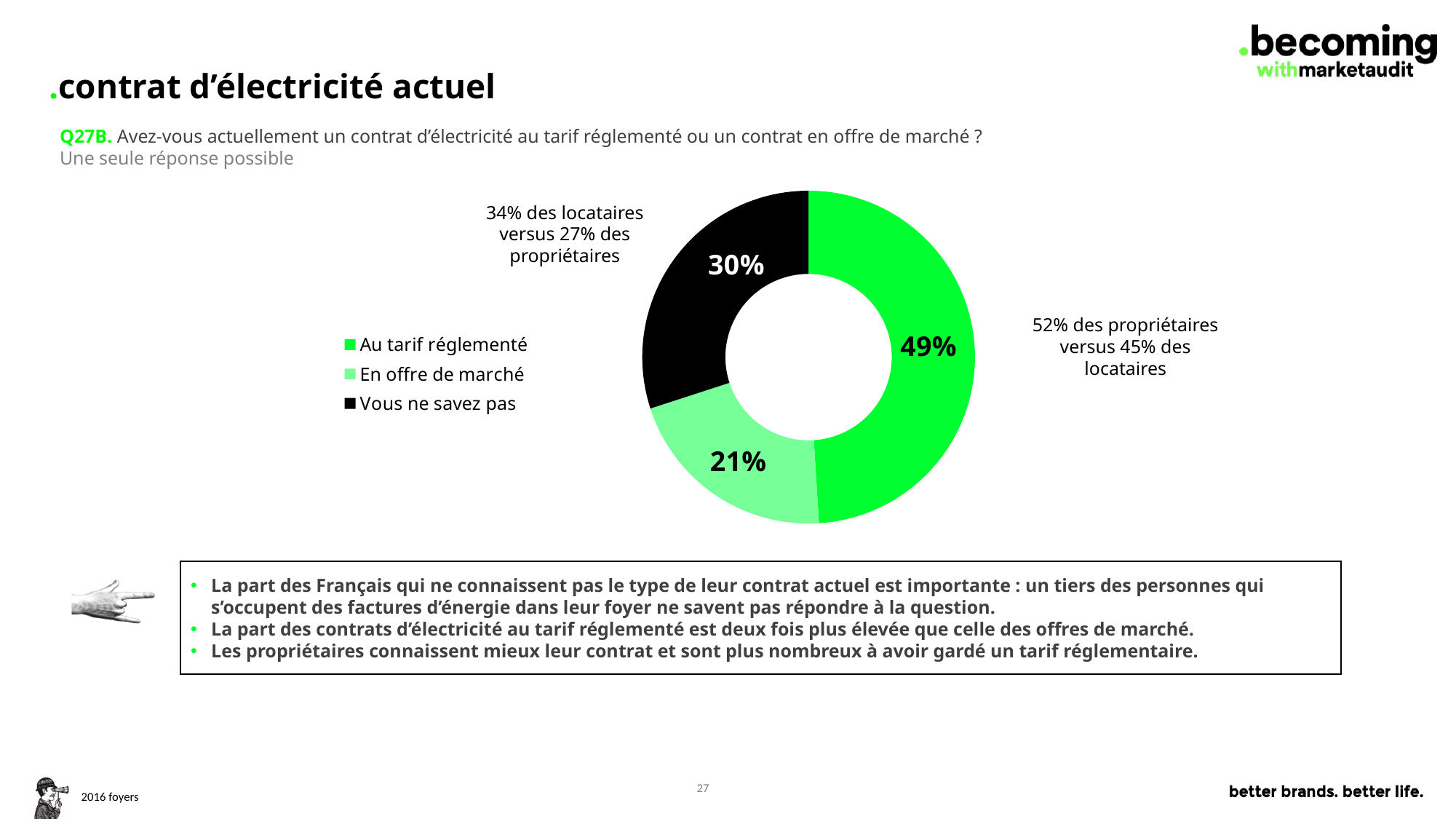
What is the difference in percentage points between 'Au tarif réglementé' and 'En offre de marché'? 28 How many categories does the pie chart show? 3 Which is larger: the share for 'Vous ne savez pas' or the share for 'En offre de marché'? Vous ne savez pas What colour is the slice for 'Vous ne savez pas'? Black Which category has the smallest share of the pie? En offre de marché What share of respondents have a contract 'En offre de marché'? 21% Which category has the largest share of the pie? Au tarif réglementé What share of respondents answered 'Vous ne savez pas'? 30% According to the annotation, what share of 'propriétaires' are at the regulated tariff? 52% What is the combined share of 'Au tarif réglementé' and 'En offre de marché'? 70% What kind of chart is shown on the slide? Pie chart (donut) What share of respondents have a contract 'Au tarif réglementé'? 49%